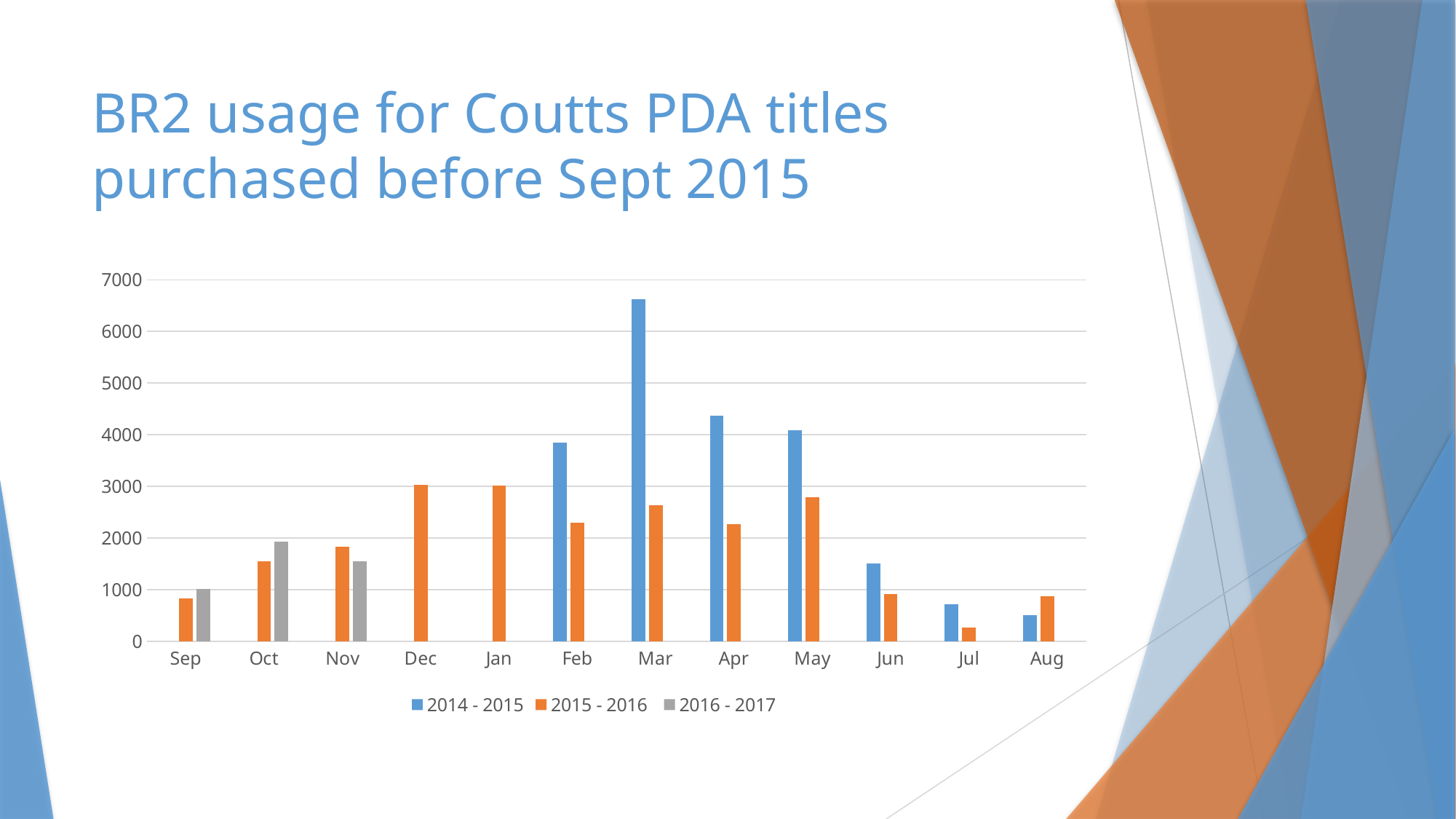
Is the value for 2014 - 2015 in Mar greater or less than 6000? greater Is the value for 2015 - 2016 in Jul greater or less than 500? less Is the value for 2015 - 2016 in Feb greater or less than 2000? greater In which month is the 2015 - 2016 series lowest? Jul How many months are shown along the x axis? 12 How many series does the legend list? 3 Does the 2014 - 2015 series rise or fall from Mar to Aug? Fall In which month is the 2016 - 2017 series highest? Oct In which month is the 2014 - 2015 series highest? Mar What kind of chart is shown on the slide? Bar chart In Nov, which series has the larger value, 2015 - 2016 or 2016 - 2017? 2015 - 2016 In Oct, which series has the larger value, 2015 - 2016 or 2016 - 2017? 2016 - 2017